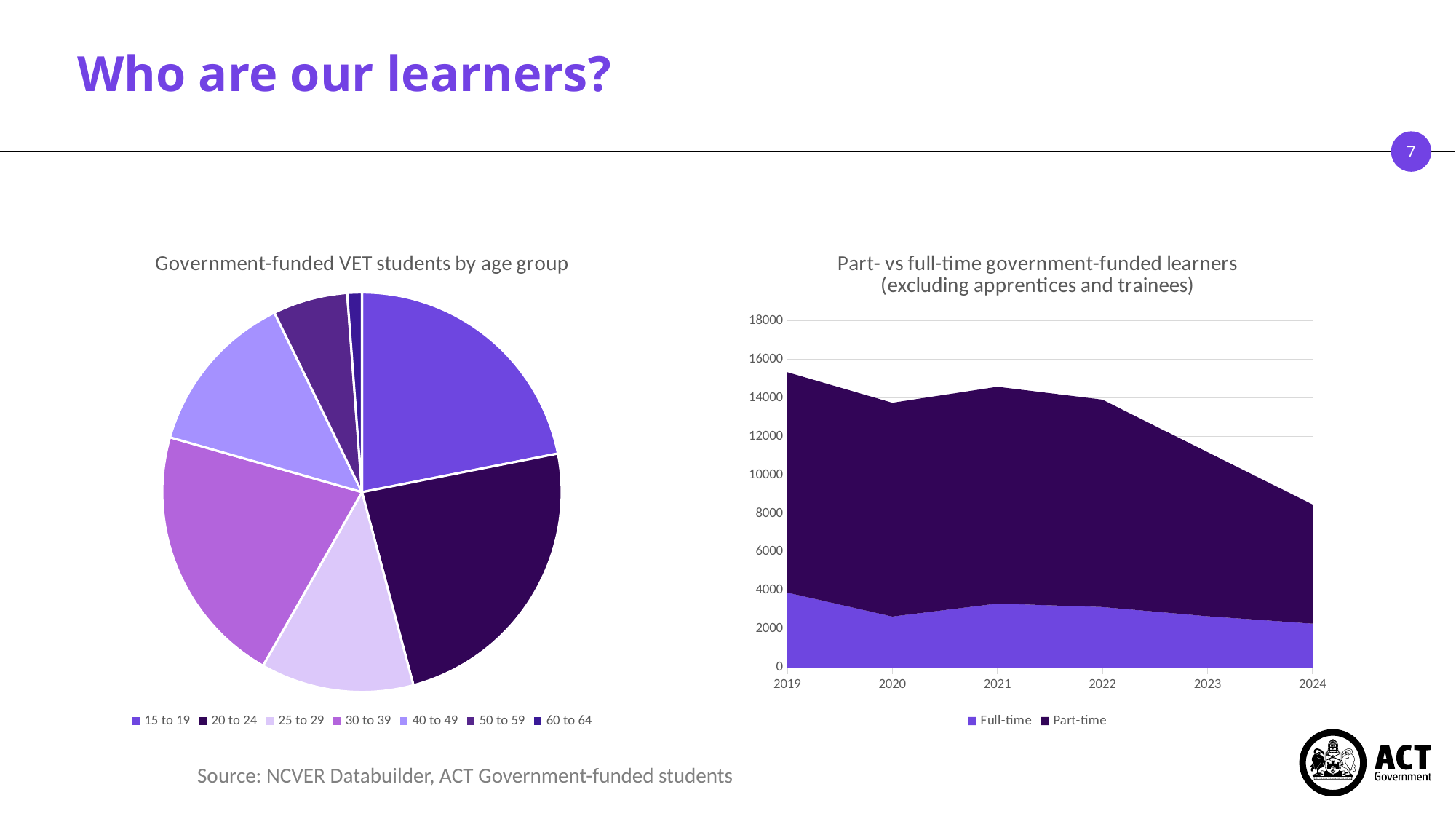
In the 'Part- vs full-time government-funded learners' chart, does the total number of learners rise or fall from 2019 to 2024? fall In the 'Part- vs full-time government-funded learners' chart, how many series does the legend list? 2 In the 'Part- vs full-time government-funded learners' chart, is the total number of learners in 2019 greater or less than 14000? greater What kind of chart is the left chart, 'Government-funded VET students by age group'? pie chart In the 'Part- vs full-time government-funded learners' chart, how many years are shown on the x axis? 6 What kind of chart is the right chart, 'Part- vs full-time government-funded learners'? area chart In the 'Government-funded VET students by age group' pie chart, which age group has the smallest slice? 60 to 64 In the 'Government-funded VET students by age group' pie chart, which slice is larger: 40 to 49 or 50 to 59? 40 to 49 In the 'Part- vs full-time government-funded learners' chart, which series is larger in every year: Full-time or Part-time? Part-time In the 'Government-funded VET students by age group' pie chart, which slice is larger: 30 to 39 or 25 to 29? 30 to 39 In the 'Government-funded VET students by age group' pie chart, how many age groups does the legend list? 7 In the 'Part- vs full-time government-funded learners' chart, is the total number of learners in 2024 greater or less than 10000? less